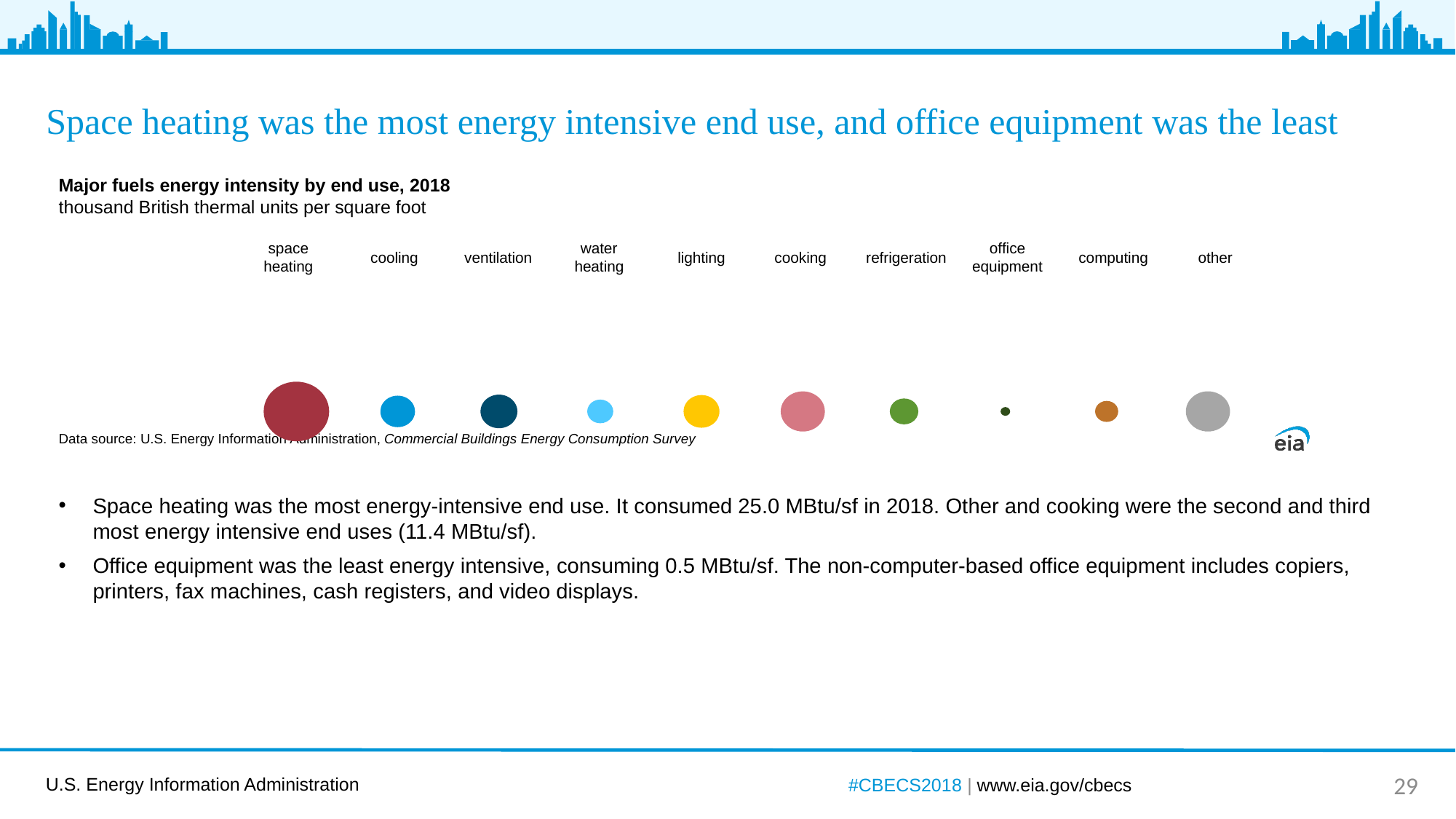
According to the slide, what is the difference between the energy intensity of space heating and office equipment? 24.5 MBtu/sf What unit is the chart measured in? thousand British thermal units per square foot Which is larger in the chart, the bubble for cooking or the bubble for water heating? cooking Which is larger in the chart, the bubble for other or the bubble for computing? other How many end-use categories are shown in the chart? 10 What kind of chart is shown on the slide? bubble chart According to the slide, what was the energy intensity of office equipment? 0.5 MBtu/sf Which end use has the largest bubble in the chart? space heating Which end use has the smallest bubble in the chart? office equipment What is the title of the chart? Major fuels energy intensity by end use, 2018 Which is larger in the chart, the bubble for space heating or the bubble for cooling? space heating According to the slide, what was the energy intensity of space heating in 2018? 25.0 MBtu/sf